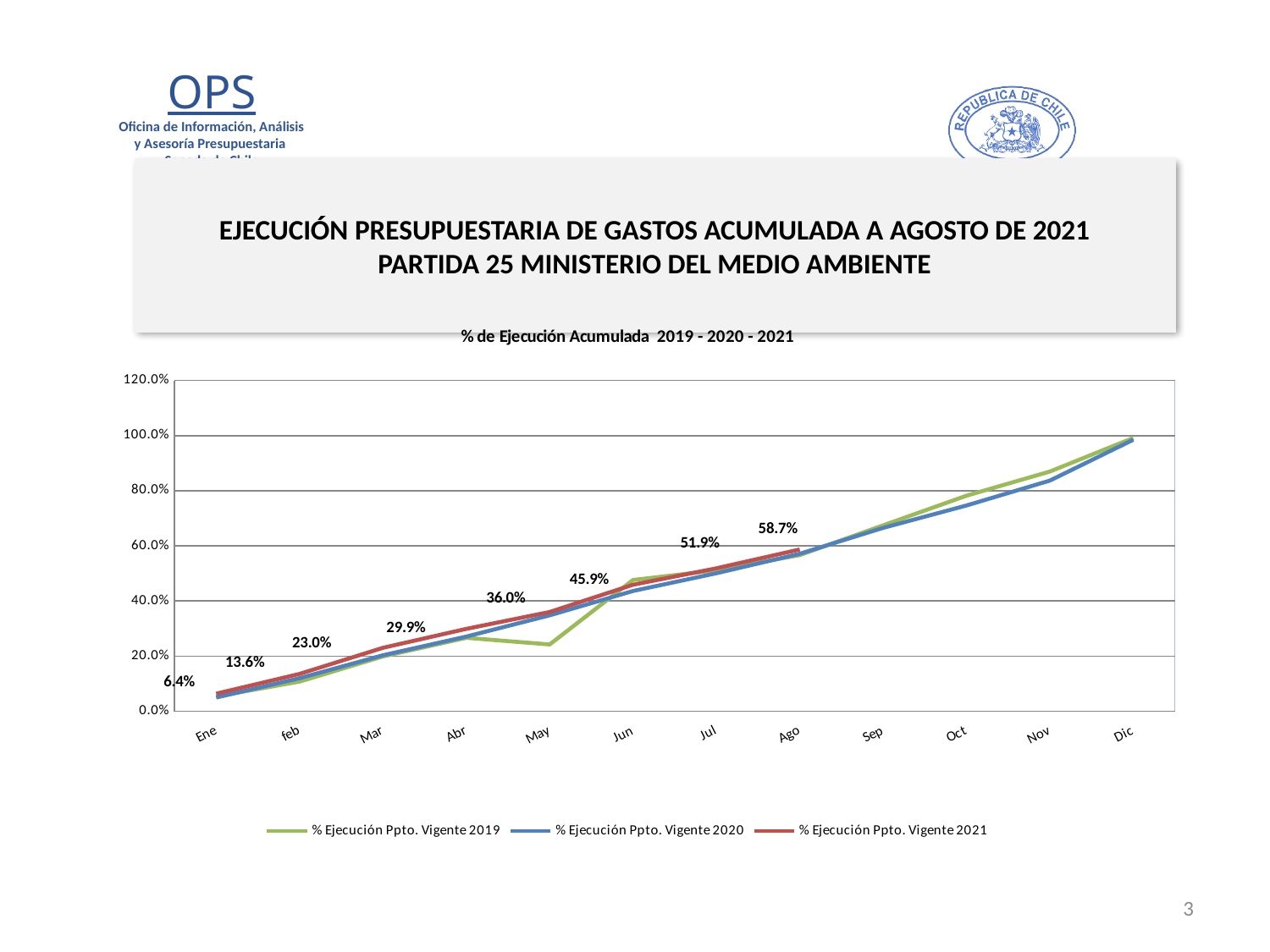
What is the value of % Ejecución Ppto. Vigente 2021 for Ene? 6.4% What is the value of % Ejecución Ppto. Vigente 2021 for Ago? 58.7% What kind of chart is shown on the slide? line chart Does the % Ejecución Ppto. Vigente 2021 line rise or fall from Ene to Ago? rise What is the difference between the 2021 values for Mar and feb? 9.4% What is the value of % Ejecución Ppto. Vigente 2021 for Jun? 45.9% Is the value for % Ejecución Ppto. Vigente 2020 in Dic greater or less than 80.0%? greater How many months are shown along the x axis? 12 What is the value of % Ejecución Ppto. Vigente 2021 for May? 36.0% What is the difference between the 2021 values for Ago and Jul? 6.8% In May, which series has the larger value: % Ejecución Ppto. Vigente 2019 or % Ejecución Ppto. Vigente 2020? % Ejecución Ppto. Vigente 2020 How many series does the legend list? 3